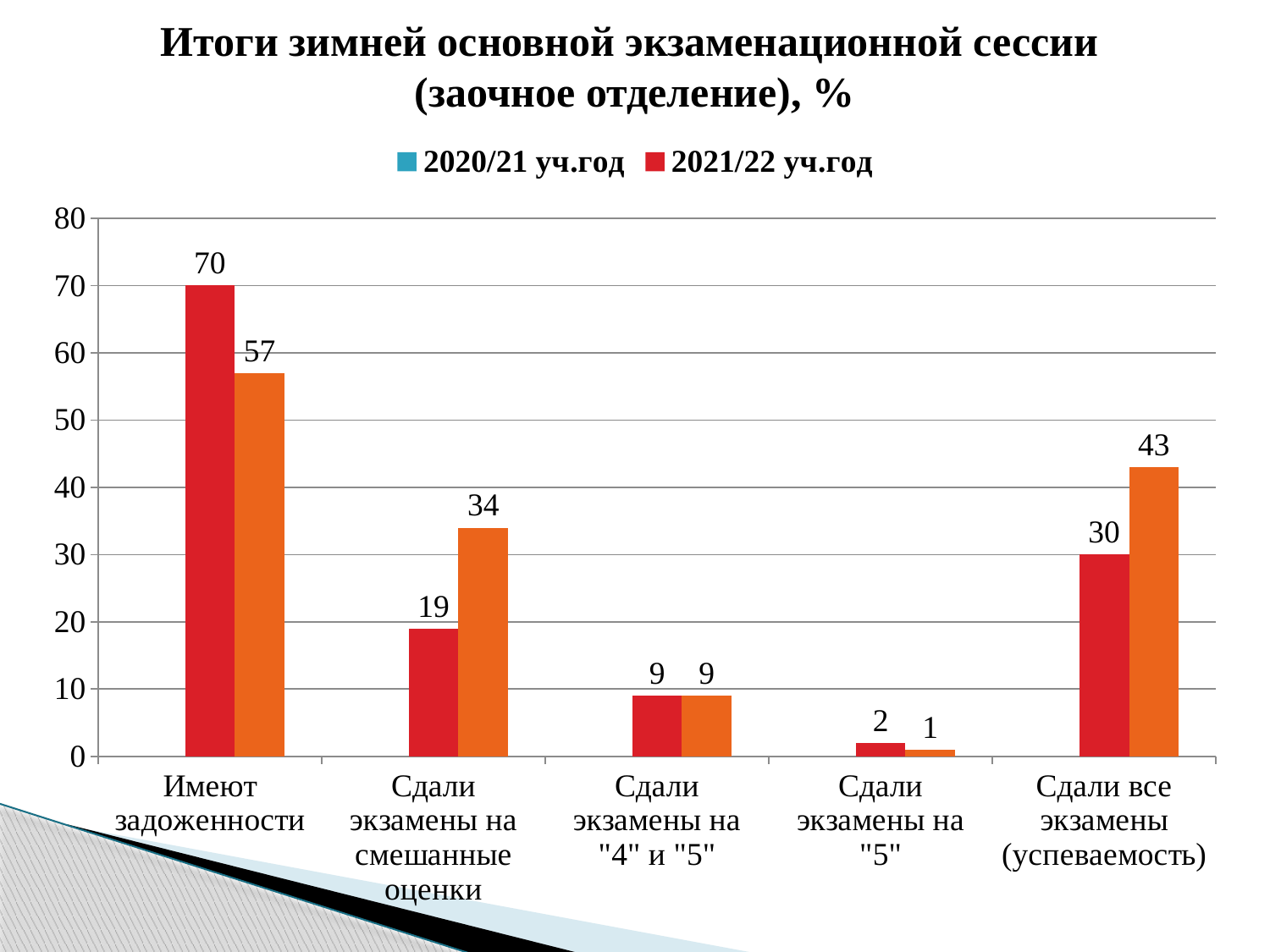
What are the two entries listed in the legend? 2020/21 уч.год and 2021/22 уч.год What is the value of the orange bar for "Сдали все экзамены (успеваемость)"? 43 What is the value of the orange bar for "Сдали экзамены на смешанные оценки"? 34 How many series does the legend list? 2 What is the difference between the orange and red bars for "Сдали экзамены на смешанные оценки"? 15 For "Сдали все экзамены (успеваемость)", which bar is larger, the red or the orange one? orange How many categories are shown on the x axis? 5 What is the value of the red bar for "Имеют задоженности"? 70 Which category has the lowest orange bar? Сдали экзамены на "5" What type of chart is shown on the slide? bar chart Which category has the highest red bar? Имеют задоженности What is the difference between the red and orange bars for "Имеют задоженности"? 13